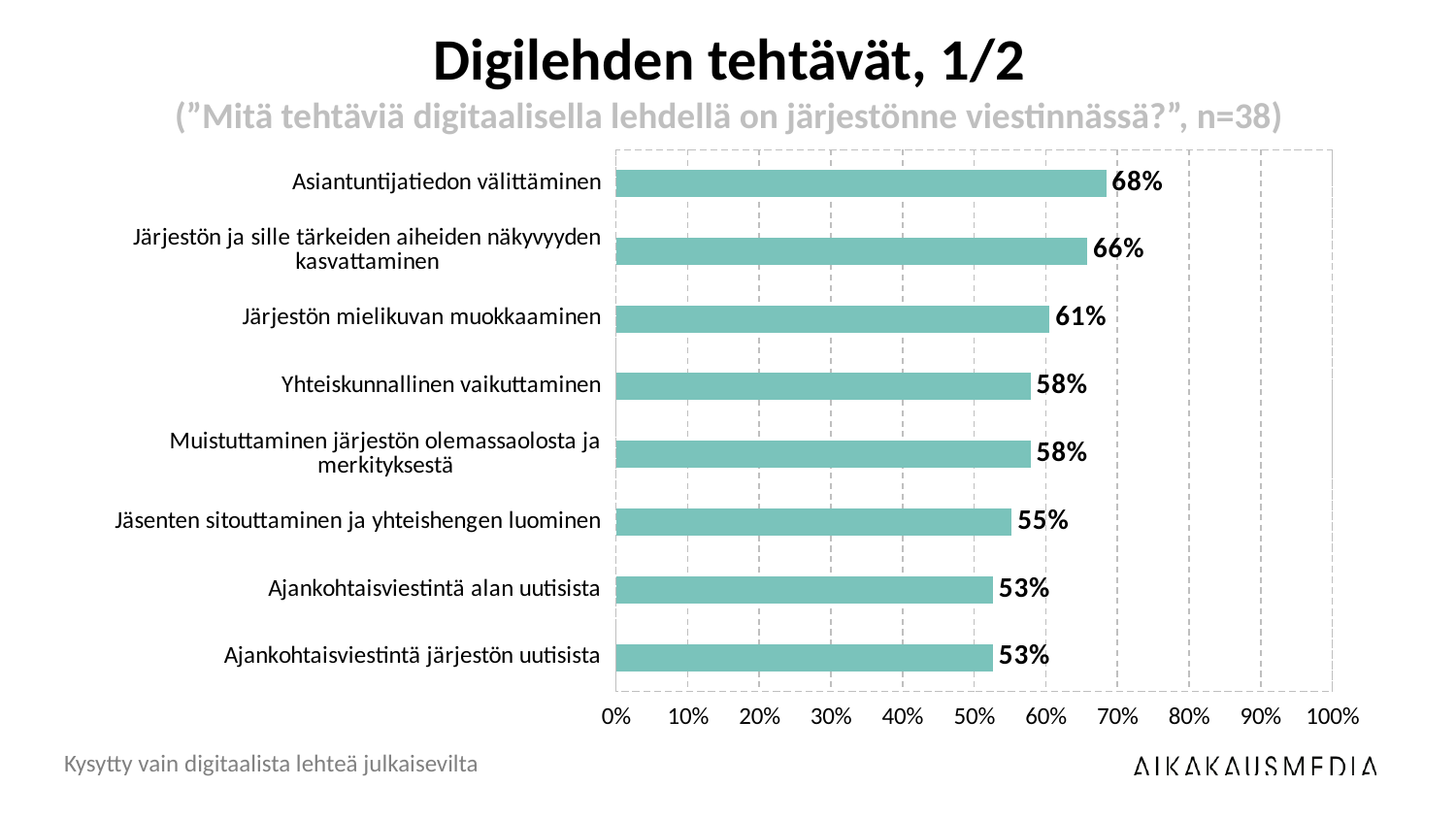
How many categories are shown in the chart? 8 What is the difference between Järjestön ja sille tärkeiden aiheiden näkyvyyden kasvattaminen and Yhteiskunnallinen vaikuttaminen? 8% What is the difference between Asiantuntijatiedon välittäminen and Ajankohtaisviestintä järjestön uutisista? 15% Which category has the highest value? Asiantuntijatiedon välittäminen What is the title of the chart? Digilehden tehtävät, 1/2 What is the value for Jäsenten sitouttaminen ja yhteishengen luominen? 55% Is the value for Muistuttaminen järjestön olemassaolosta ja merkityksestä greater or less than 50%? greater What kind of chart is shown on the slide? Bar chart What is the value for Ajankohtaisviestintä alan uutisista? 53% Which is larger, the value for Järjestön mielikuvan muokkaaminen or the value for Jäsenten sitouttaminen ja yhteishengen luominen? Järjestön mielikuvan muokkaaminen What is the value for Järjestön mielikuvan muokkaaminen? 61% What is the value for Asiantuntijatiedon välittäminen? 68%